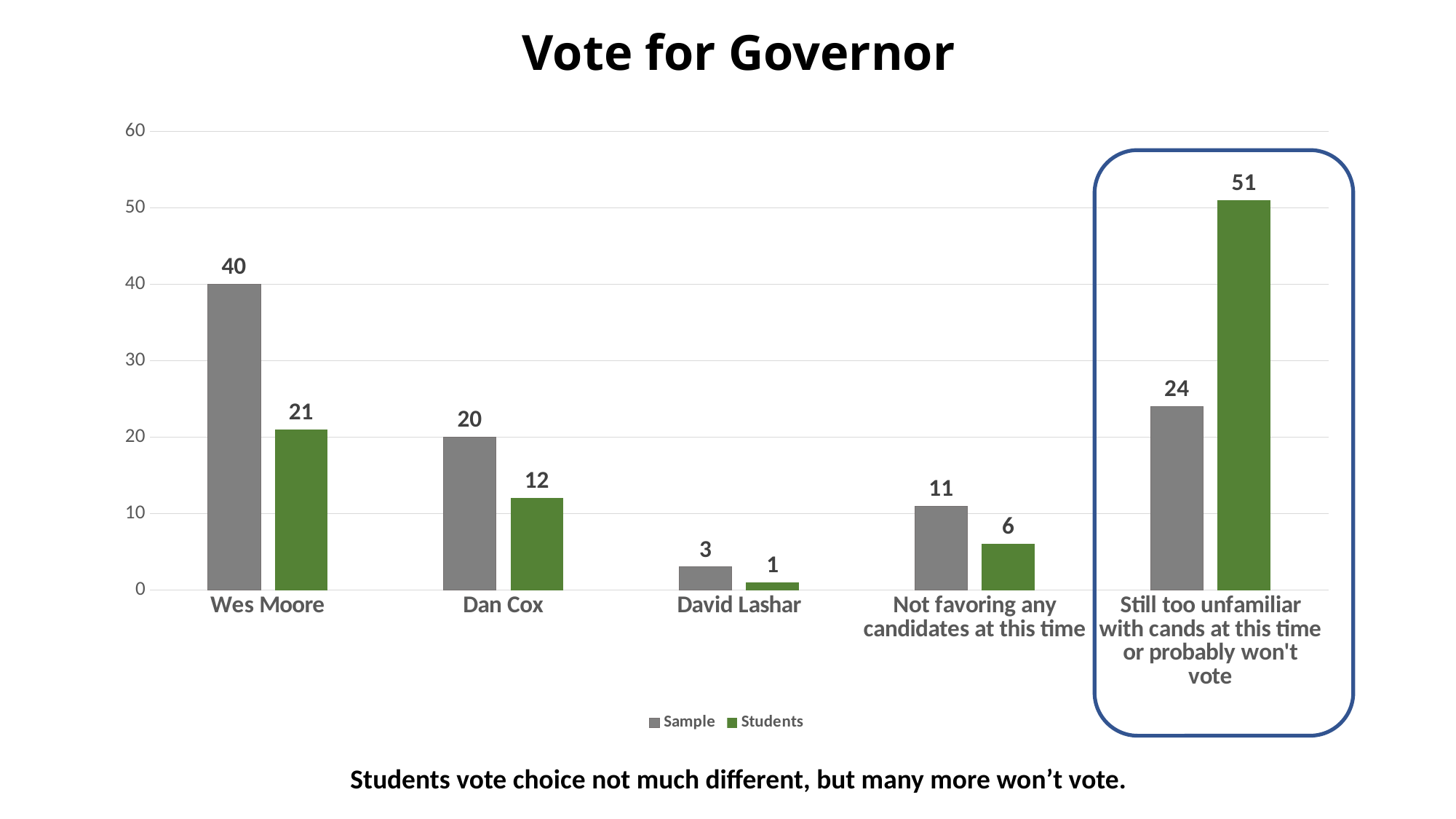
Is the Students value for 'Still too unfamiliar with cands at this time or probably won't vote' greater or less than 50? greater Which category has the lowest Sample value? David Lashar Which is larger for 'Not favoring any candidates at this time': the Sample value or the Students value? Sample What is the title of the chart? Vote for Governor What is the Students value for Dan Cox? 12 What is the Sample value for Wes Moore? 40 What kind of chart is shown on the slide? Bar chart Which category has the highest Students value? Still too unfamiliar with cands at this time or probably won't vote How many categories are shown on the x axis? 5 What is the Students value for 'Still too unfamiliar with cands at this time or probably won't vote'? 51 How many series does the legend list? 2 What is the difference between the Sample and Students values for Wes Moore? 19